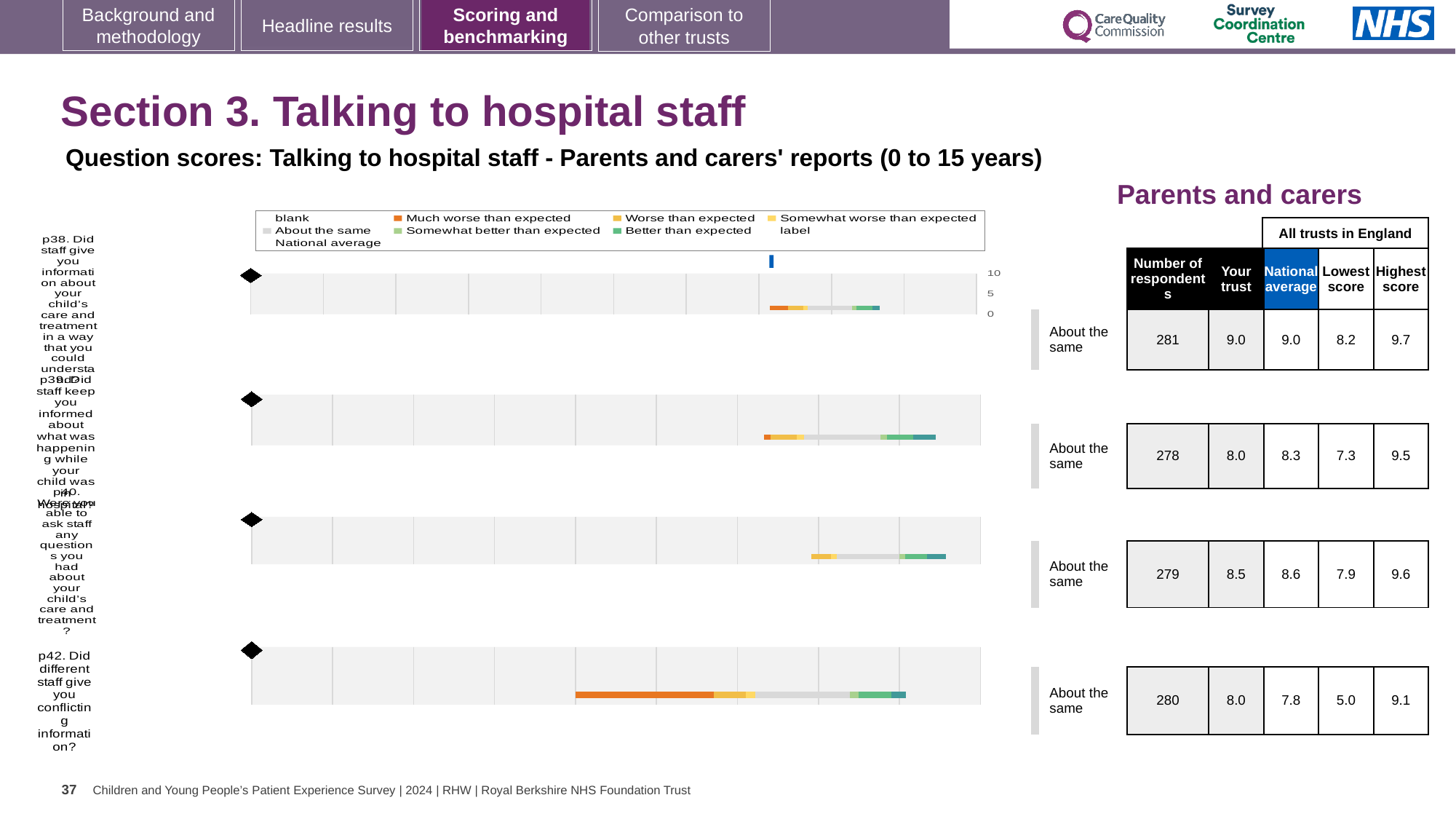
In the chart legend, what colour represents 'About the same'? light grey In the table beside the charts, how many respondents are listed for p42 (different staff giving conflicting information)? 280 How many entries does the chart legend list? 9 Which question has the lowest 'Lowest score' value in the table beside the charts? p42 In the table beside the charts, what is the 'Your trust' score for p38 (staff giving information about your child's care and treatment)? 9.0 What kind of chart is used to show the question scores for p38 to p42? bar chart How many question charts (p38, p39, p40, p42) are shown on the slide? 4 Which question has the highest 'Your trust' score in the table beside the charts? p38 In the chart legend, what colour represents 'Much worse than expected'? orange For p40, which is larger in the table beside the charts: the 'Your trust' score or the National average? National average In the table beside the charts, what is the National average for p39 (staff keeping you informed about what was happening)? 8.3 For p42, what is the difference between the Highest score and the Lowest score in the table beside the charts? 4.1